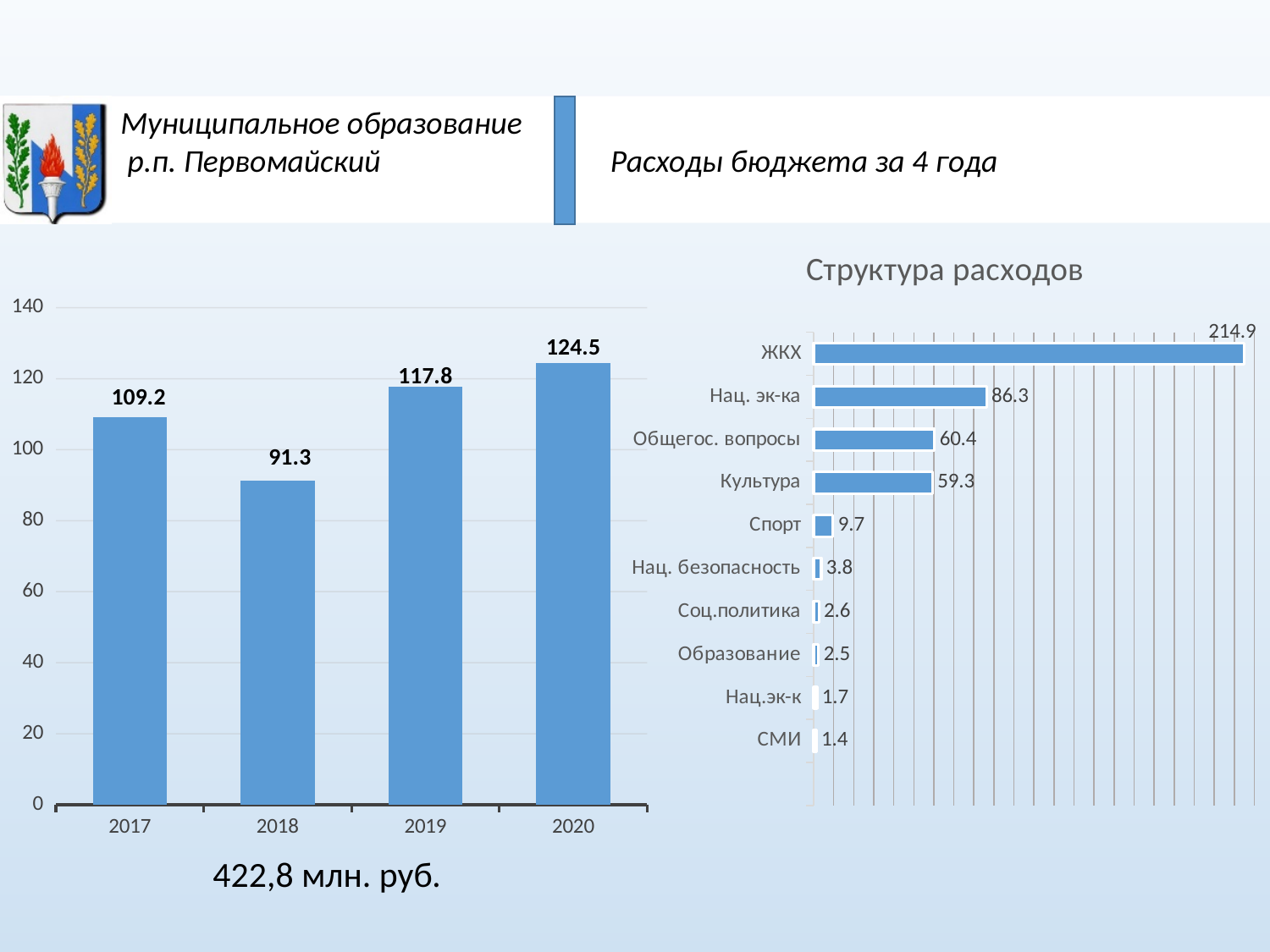
In the chart titled 'Структура расходов', what is the value for ЖКХ? 214.9 In the left chart, is the value for 2019 greater or less than 100? greater In the left chart, which year has the lowest value? 2018 In the left chart, what is the difference between the values for 2020 and 2017? 15.3 What kind of chart is the chart titled 'Структура расходов'? Bar chart In the chart titled 'Структура расходов', which is larger: Нац. эк-ка or Общегос. вопросы? Нац. эк-ка In the chart titled 'Структура расходов', which category has the lowest value? СМИ In the chart titled 'Структура расходов', how many categories are shown? 10 In the left chart, which year has the highest value? 2020 In the left chart, what is the value for 2018? 91.3 In the left chart, how many years are shown on the x axis? 4 In the chart titled 'Структура расходов', what is the value for Культура? 59.3